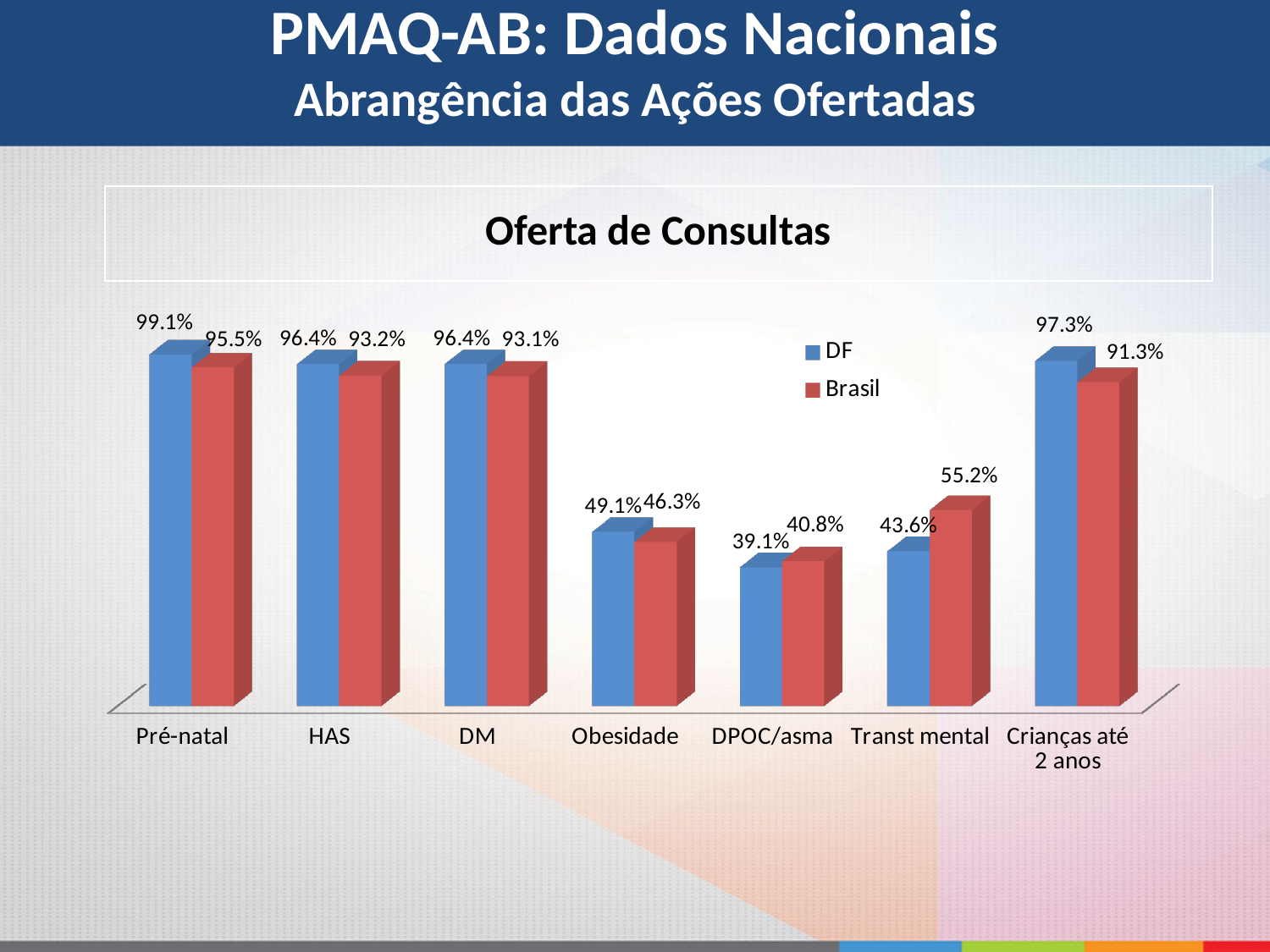
What type of chart is shown on the slide? Bar chart What is the Brasil value for Transt mental? 55.2% For DPOC/asma, which is larger: the DF value or the Brasil value? Brasil What is the Brasil value for Crianças até 2 anos? 91.3% What is the difference between the DF and Brasil values for Transt mental? 11.6% How many series does the legend list? 2 For Obesidade, which is larger: the DF value or the Brasil value? DF What is the difference between the DF and Brasil values for Crianças até 2 anos? 6.0% Which category has the lowest Brasil value? DPOC/asma Which category has the highest DF value? Pré-natal How many categories are shown on the x axis of the chart? 7 What is the DF value for Pré-natal in the Oferta de Consultas chart? 99.1%